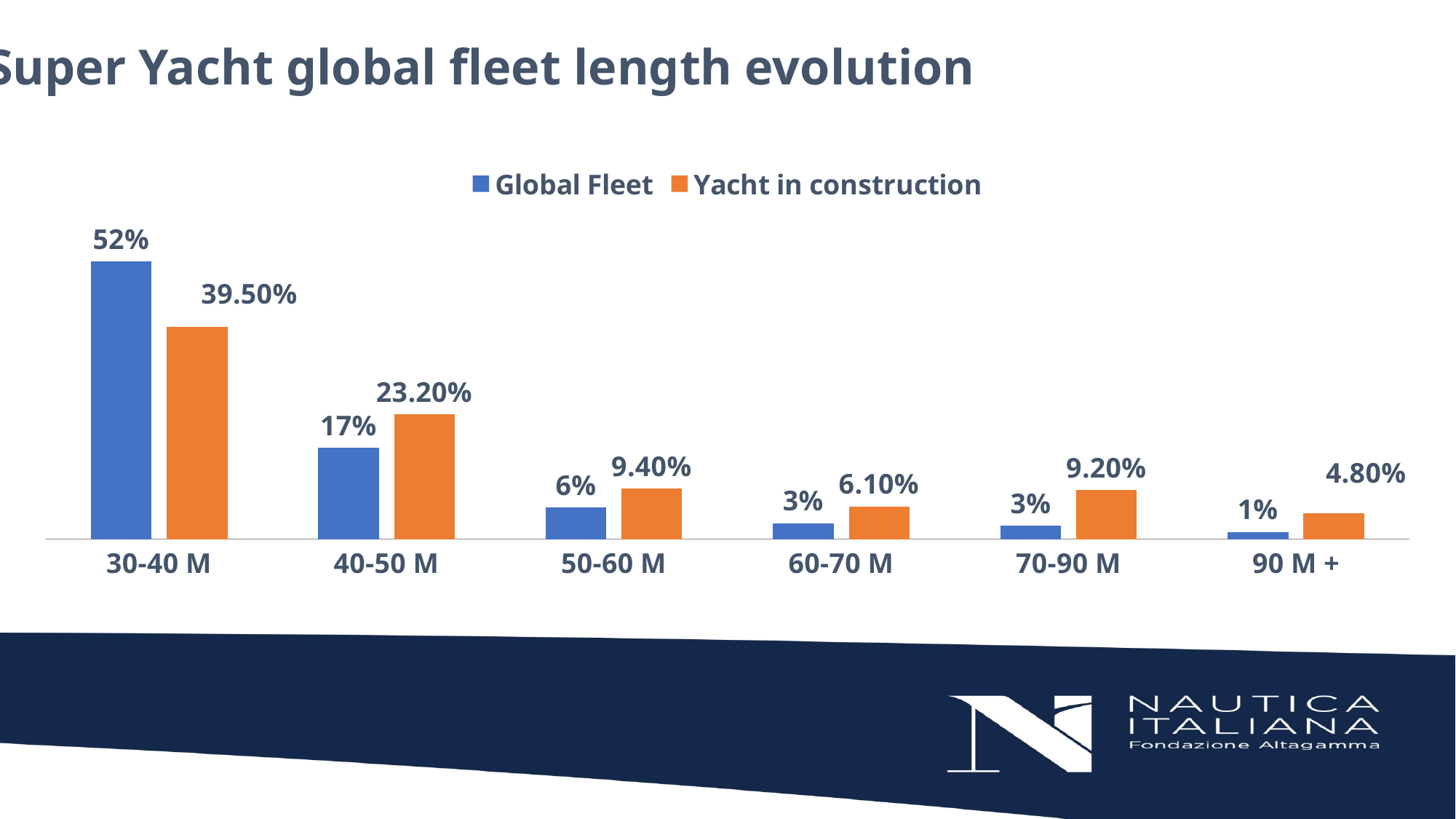
Which category has the lowest Yacht in construction value? 90 M + How many series does the legend list? 2 Do the Global Fleet values rise or fall from 30-40 M to 90 M +? Fall What is the Yacht in construction value for the 40-50 M category? 23.20% For the 70-90 M category, which series has the larger value: Global Fleet or Yacht in construction? Yacht in construction What is the Yacht in construction value for the 90 M + category? 4.80% What is the title of the chart? Super Yacht global fleet length evolution What kind of chart is shown on the slide? Bar chart Which category has the highest Global Fleet value? 30-40 M What is the difference between the Global Fleet and Yacht in construction values for the 30-40 M category? 12.50% What is the Global Fleet value for the 30-40 M category? 52% How many length categories are shown on the x axis? 6